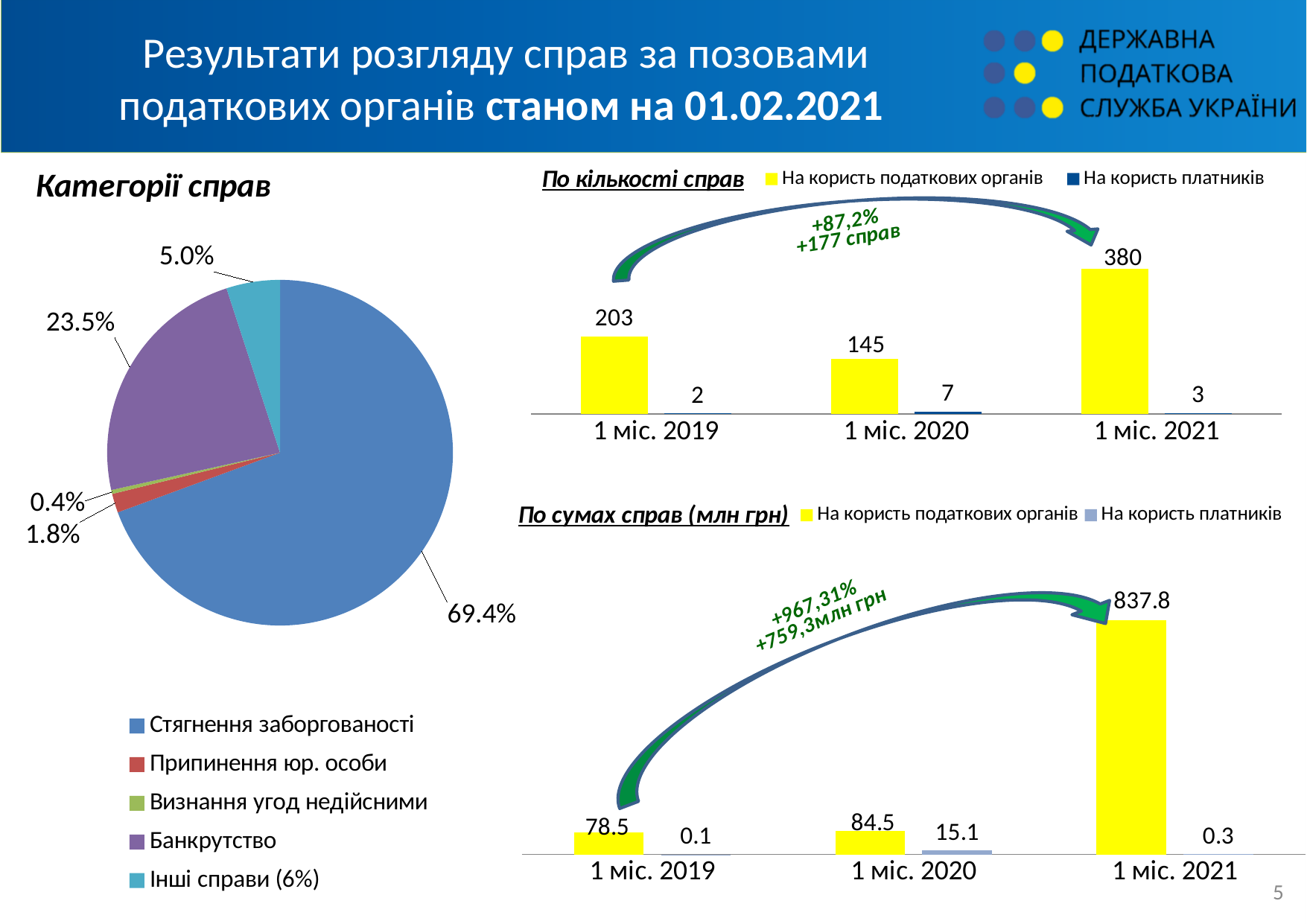
In the pie chart 'Категорії справ', what share does 'Банкрутство' have? 23.5% In the pie chart 'Категорії справ', which category has the largest share? Стягнення заборгованості In the chart 'По кількості справ', what is the difference between the 'На користь податкових органів' values for 1 міс. 2021 and 1 міс. 2019? 177 In the chart 'По сумах справ (млн грн)', what is the value for 'На користь податкових органів' in 1 міс. 2021? 837.8 In the chart 'По кількості справ', what is the value for 'На користь платників' in 1 міс. 2020? 7 How many series does the legend of the chart 'По сумах справ (млн грн)' list? 2 In the chart 'По сумах справ (млн грн)', what is the value for 'На користь платників' in 1 міс. 2020? 15.1 In the chart 'По сумах справ (млн грн)', which is larger: 'На користь податкових органів' in 1 міс. 2019 or in 1 міс. 2020? 1 міс. 2020 In the chart 'По кількості справ', what is the value for 'На користь податкових органів' in 1 міс. 2021? 380 How many categories does the legend of the pie chart 'Категорії справ' list? 5 In the pie chart 'Категорії справ', which category has the smallest share? Визнання угод недійсними In the chart 'По кількості справ', which period has the lowest value for 'На користь податкових органів'? 1 міс. 2020